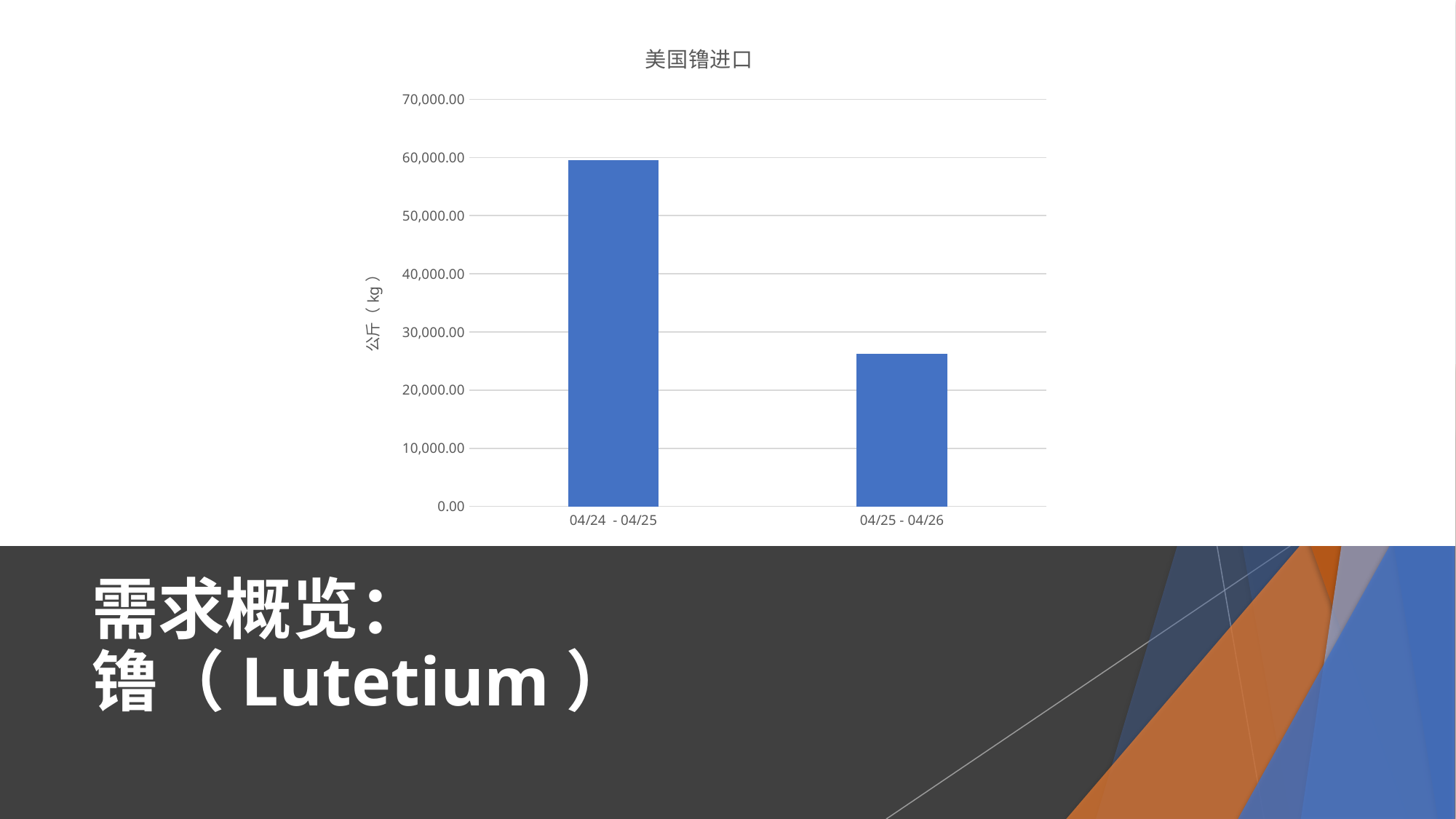
Is the value for 04/25 - 04/26 greater or less than 30,000.00? less Which category has the highest value in the chart? 04/24 - 04/25 What is the title of the chart? 美国镥进口 Do the values rise or fall from 04/24 - 04/25 to 04/25 - 04/26? fall What kind of chart is shown on the slide? bar chart Which is larger, the value for 04/24 - 04/25 or the value for 04/25 - 04/26? 04/24 - 04/25 Which category has the lowest value in the chart? 04/25 - 04/26 Is the value for 04/25 - 04/26 greater or less than 20,000.00? greater Is the value for 04/24 - 04/25 greater or less than 50,000.00? greater What is the label on the vertical axis of the chart? 公斤（kg） How many categories are plotted on the x axis of the chart? 2